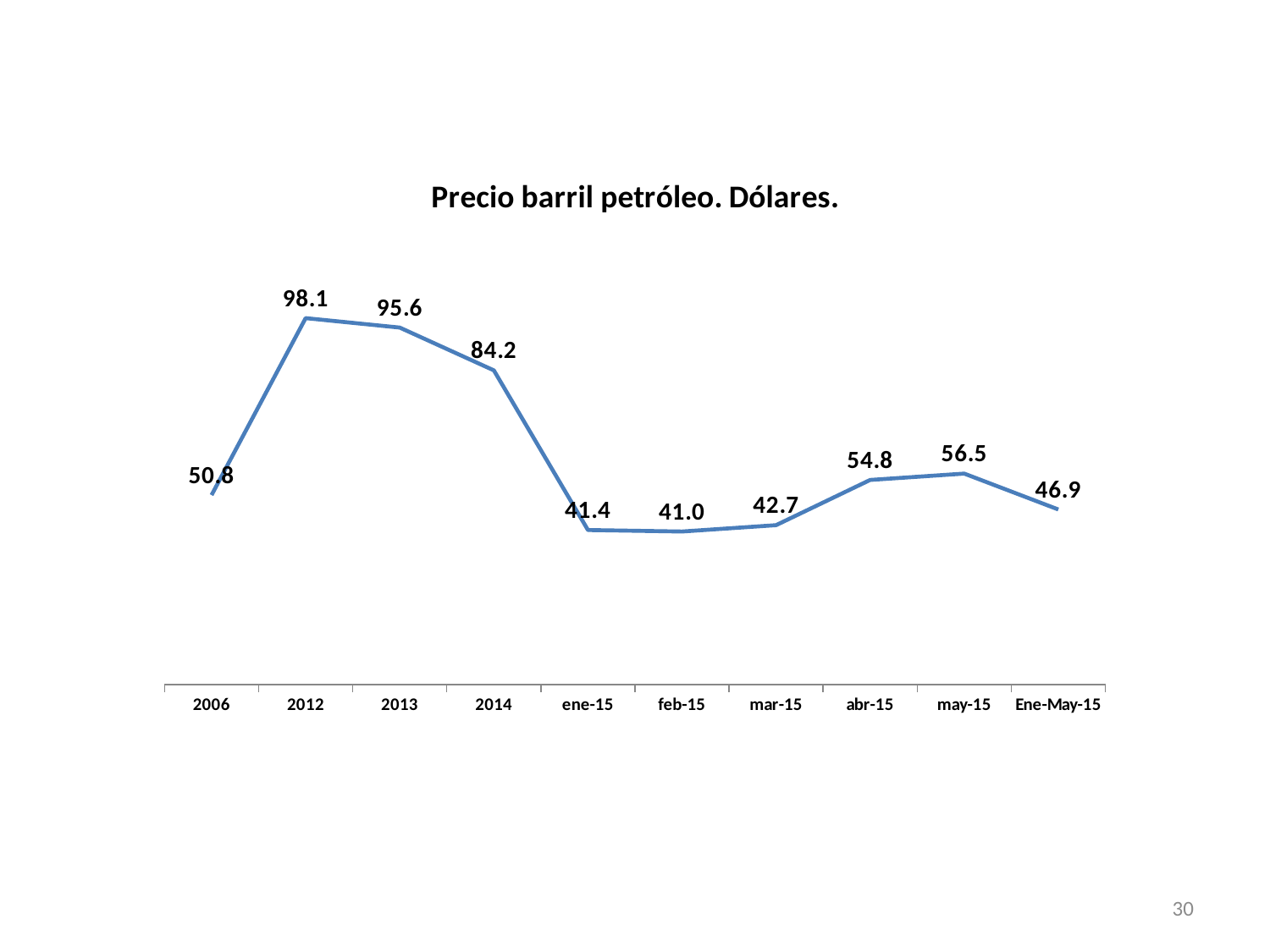
What is the oil barrel price shown for 2012? 98.1 What is the title of the chart? Precio barril petróleo. Dólares. Which category has the lowest value on the chart? feb-15 What is the difference between the values for 2014 and ene-15? 42.8 Which is larger, the value for 2006 or the value for abr-15? abr-15 What is the value shown for feb-15? 41.0 Do the values rise or fall from 2012 to ene-15? fall How many data points are plotted on the chart? 10 What is the value shown for Ene-May-15? 46.9 Which category has the highest value on the chart? 2012 What kind of chart is shown on the slide? line chart What is the difference between the values for may-15 and abr-15? 1.7